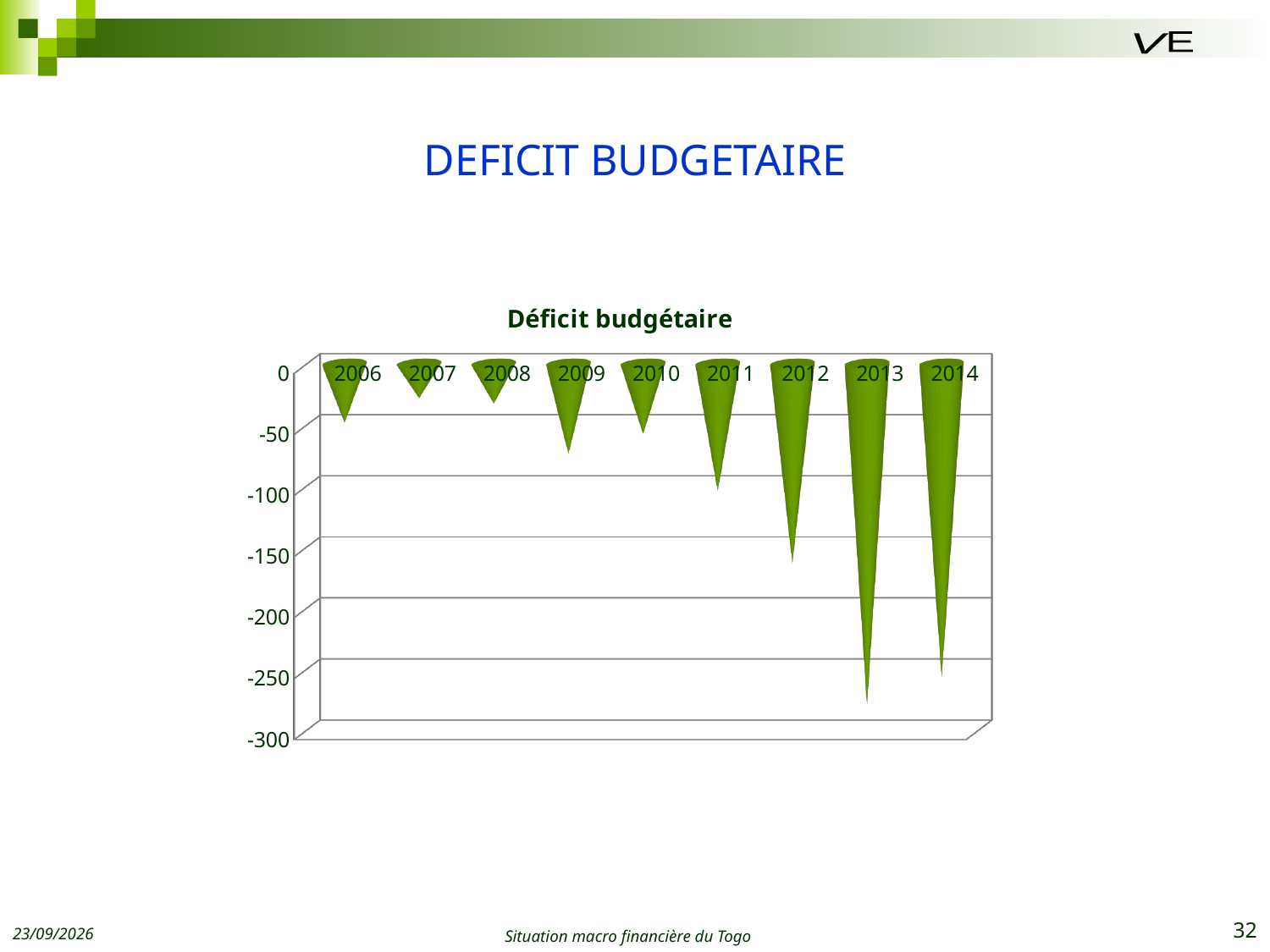
Is the value for 2012 greater or less than -100? less Is the value for 2013 greater or less than -250? less What kind of chart is shown on the slide? bar chart Which year has the lowest (most negative) value in the chart? 2013 Do the values generally rise or fall from 2006 to 2014? fall What colour are the bars in the chart? green What is the title of the chart? Déficit budgétaire Is the value for 2009 greater or less than -100? greater Which is larger, the value for 2010 or the value for 2011? 2010 Which is larger, the value for 2014 or the value for 2012? 2012 How many years are plotted on the x axis of the chart? 9